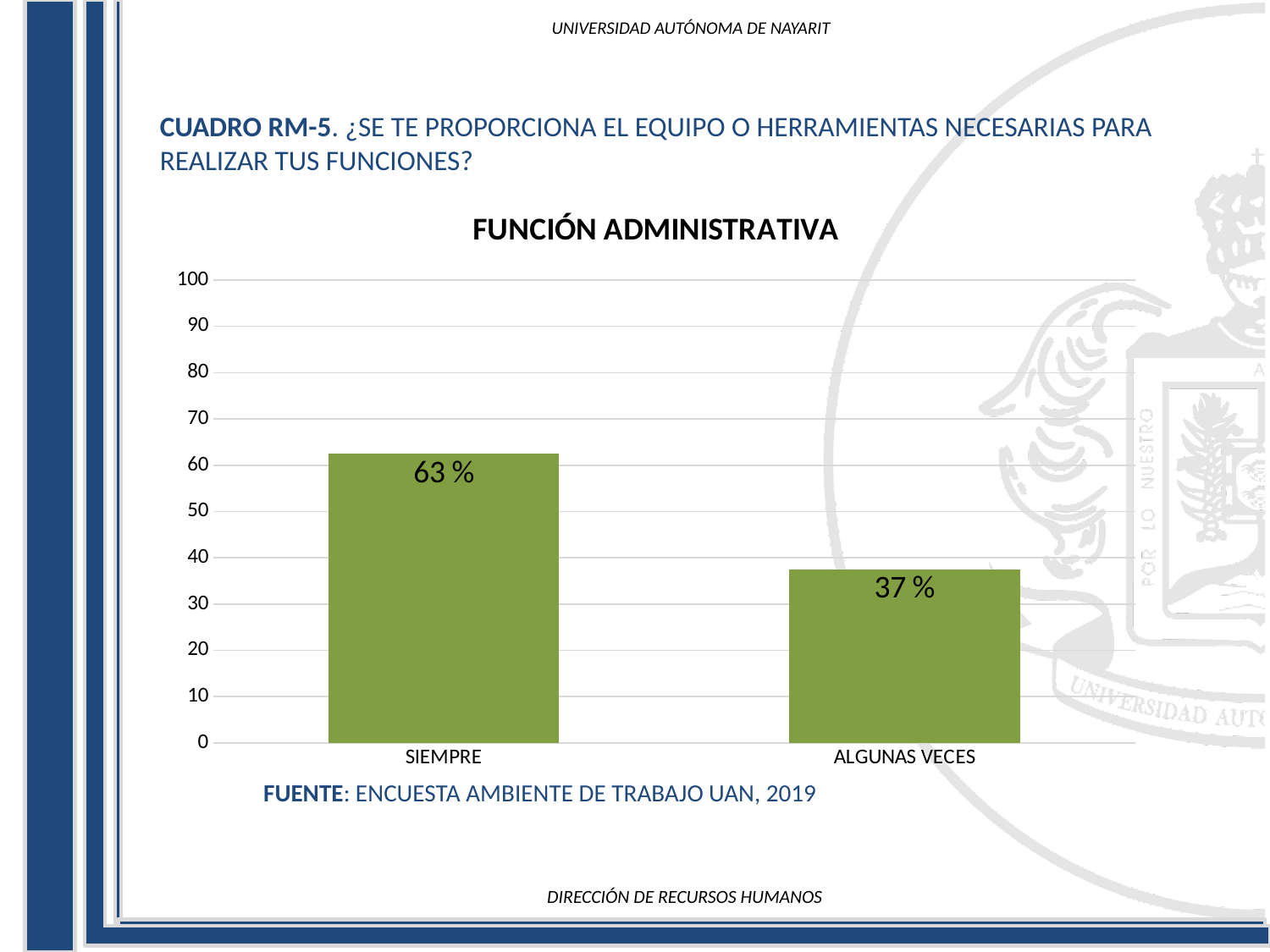
Which is larger, the value for SIEMPRE or the value for ALGUNAS VECES? SIEMPRE What is the title of the chart? FUNCIÓN ADMINISTRATIVA Which category has the highest value? SIEMPRE Is the value for SIEMPRE greater or less than 50? greater What is the difference between the values for SIEMPRE and ALGUNAS VECES? 26 % How many categories are shown in the chart? 2 What is the value for ALGUNAS VECES? 37 % Is the value for ALGUNAS VECES greater or less than 40? less What is the maximum value shown on the vertical axis? 100 What kind of chart is shown on the slide? bar chart What is the value for SIEMPRE? 63 % Which category has the lowest value? ALGUNAS VECES